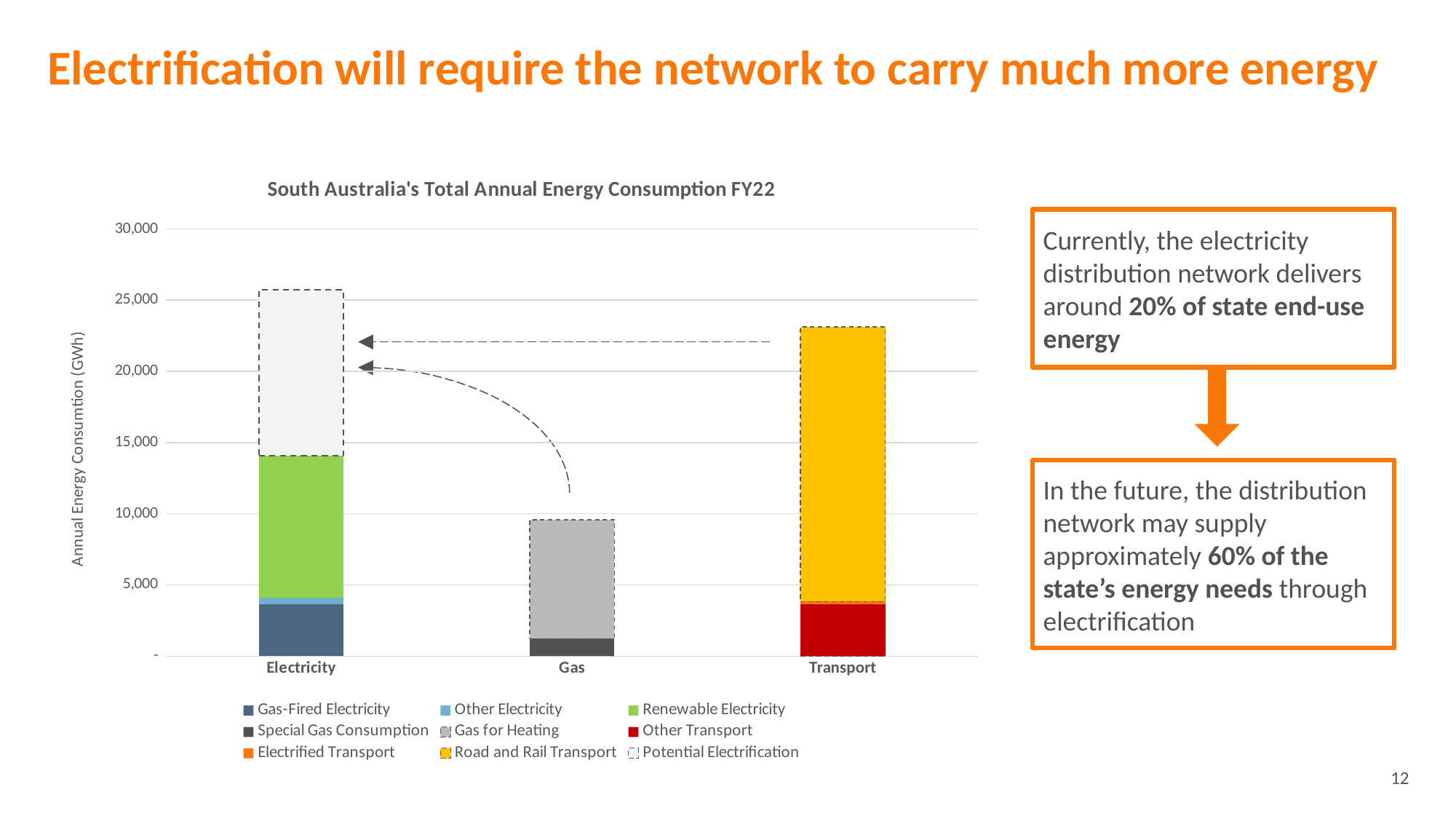
What is the title of the chart? South Australia's Total Annual Energy Consumption FY22 Which category has the shortest stacked bar? Gas Which stacked bar is taller, Transport or Gas? Transport What kind of chart is shown on the slide? Stacked bar chart Is the total height of the Gas bar greater or less than 5,000? greater Is the total height of the Transport bar greater or less than 20,000? greater Is the total height of the Electricity bar, including Potential Electrification, greater or less than 20,000? greater How many categories are shown on the x axis of the chart? 3 What is the label of the vertical axis? Annual Energy Consumption (GWh) Which category has the tallest stacked bar? Electricity How many series does the chart's legend list? 9